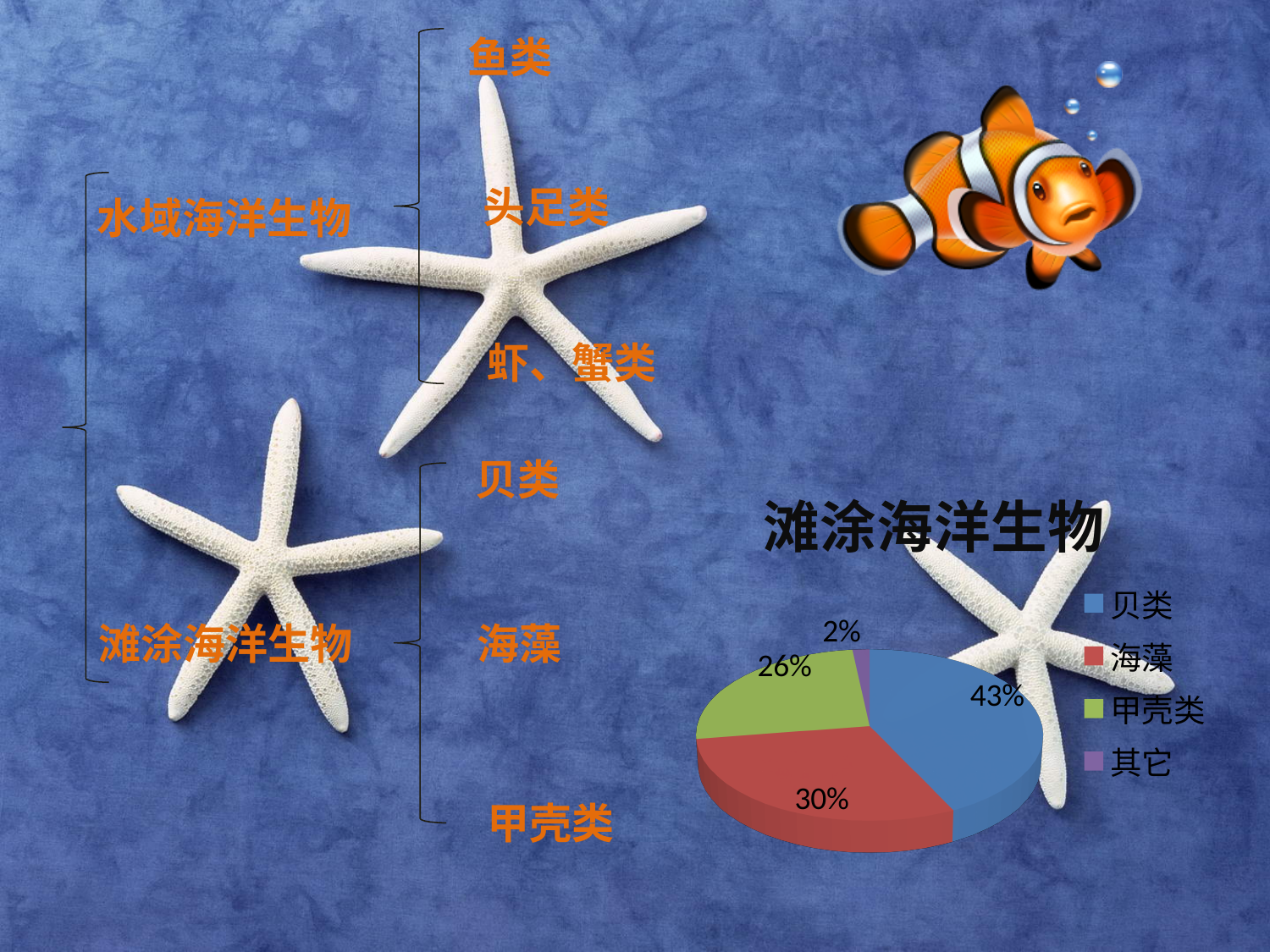
What is the title of the pie chart? 滩涂海洋生物 Which category has the largest share of the pie chart? 贝类 What percentage of the pie chart does 海藻 account for? 30% What is the difference in percentage points between 贝类 and 海藻? 13 Which category has the smallest share of the pie chart? 其它 What percentage of the pie chart does 贝类 account for? 43% What kind of chart is shown on the slide? pie chart Which has a larger share, 海藻 or 甲壳类? 海藻 What percentage of the pie chart does 甲壳类 account for? 26% What colour represents 甲壳类 in the pie chart? green How many categories does the pie chart legend list? 4 What percentage of the pie chart does 其它 account for? 2%